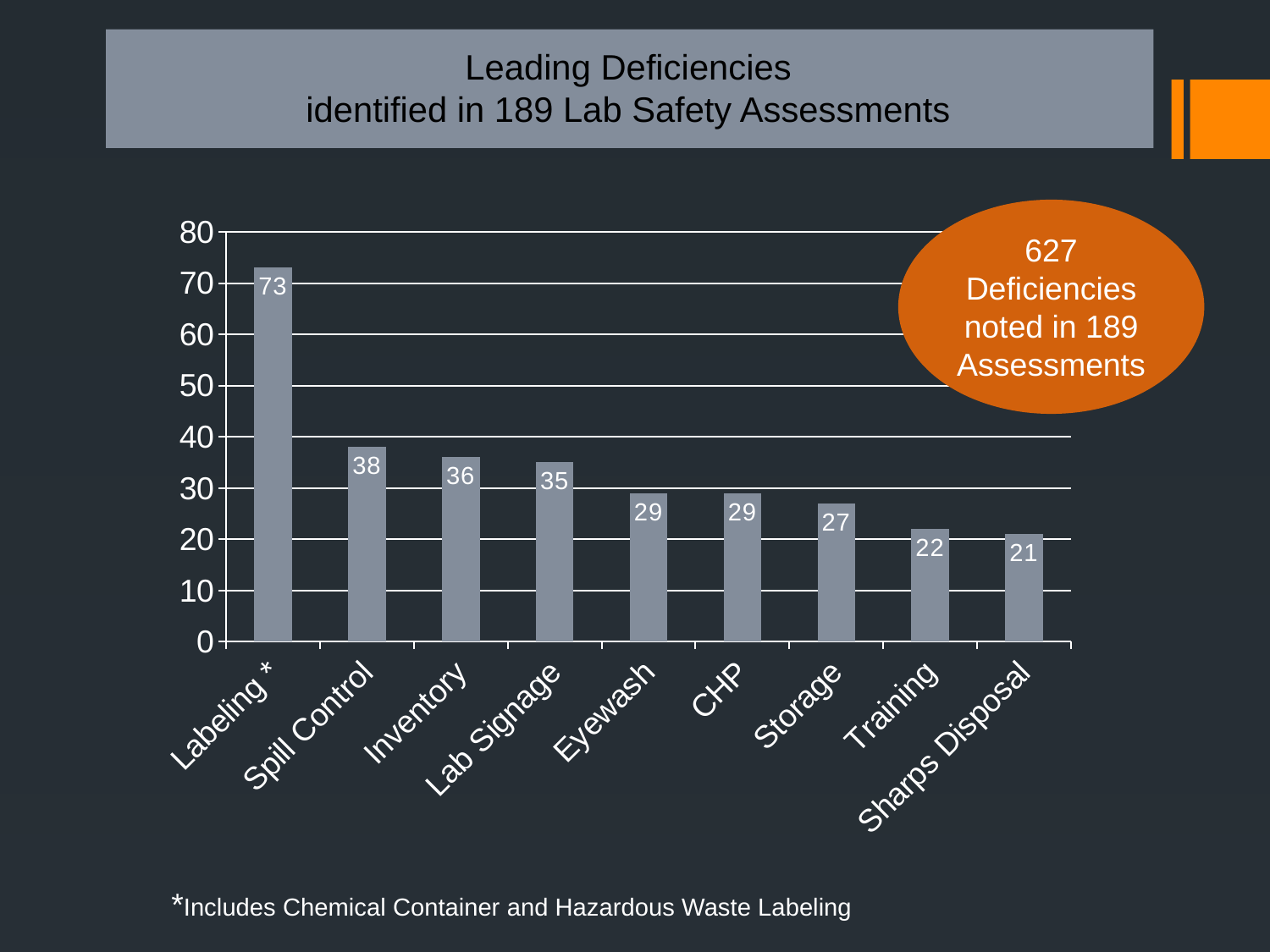
What is the value for Spill Control? 38 What is the difference between the values for Labeling * and Spill Control? 35 Which is larger, the value for Inventory or the value for Training? Inventory What is the value for Labeling *? 73 What is the value for Sharps Disposal? 21 Which category has the highest value? Labeling * Do the values generally rise or fall from left to right along the x axis? Fall What is the title of the chart? Leading Deficiencies identified in 189 Lab Safety Assessments How many categories are shown on the x axis? 9 What kind of chart is shown on the slide? Bar chart Which category has the lowest value? Sharps Disposal What is the value for Storage? 27